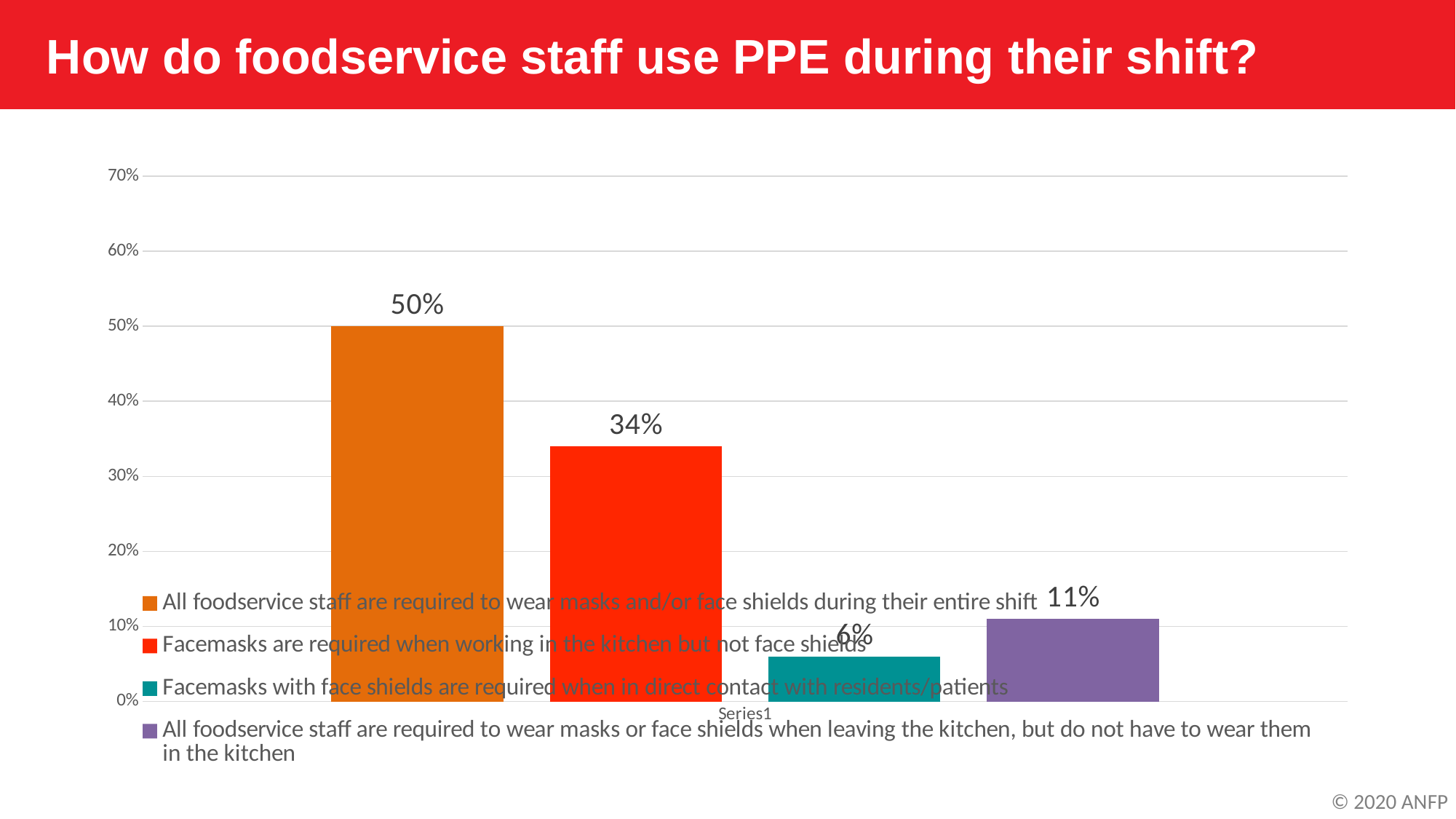
Which PPE practice has the lowest percentage? Facemasks with face shields are required when in direct contact with residents/patients What percentage of respondents said facemasks with face shields are required when in direct contact with residents/patients? 6% How many bars are shown in the chart? 4 What percentage of respondents said staff are required to wear masks or face shields when leaving the kitchen, but not in the kitchen? 11% What is the difference in percentage points between the 'entire shift' bar and the 'kitchen but not face shields' bar? 16 What percentage of respondents said facemasks are required when working in the kitchen but not face shields? 34% Which PPE practice has the highest percentage? All foodservice staff are required to wear masks and/or face shields during their entire shift What colour is the bar for 'Facemasks are required when working in the kitchen but not face shields'? Red What type of chart is shown on the slide? Bar chart Which is larger: the percentage for masks required when leaving the kitchen, or the percentage for facemasks with face shields in direct contact with residents/patients? Masks required when leaving the kitchen How many entries does the legend list? 4 What percentage of respondents said all foodservice staff are required to wear masks and/or face shields during their entire shift? 50%